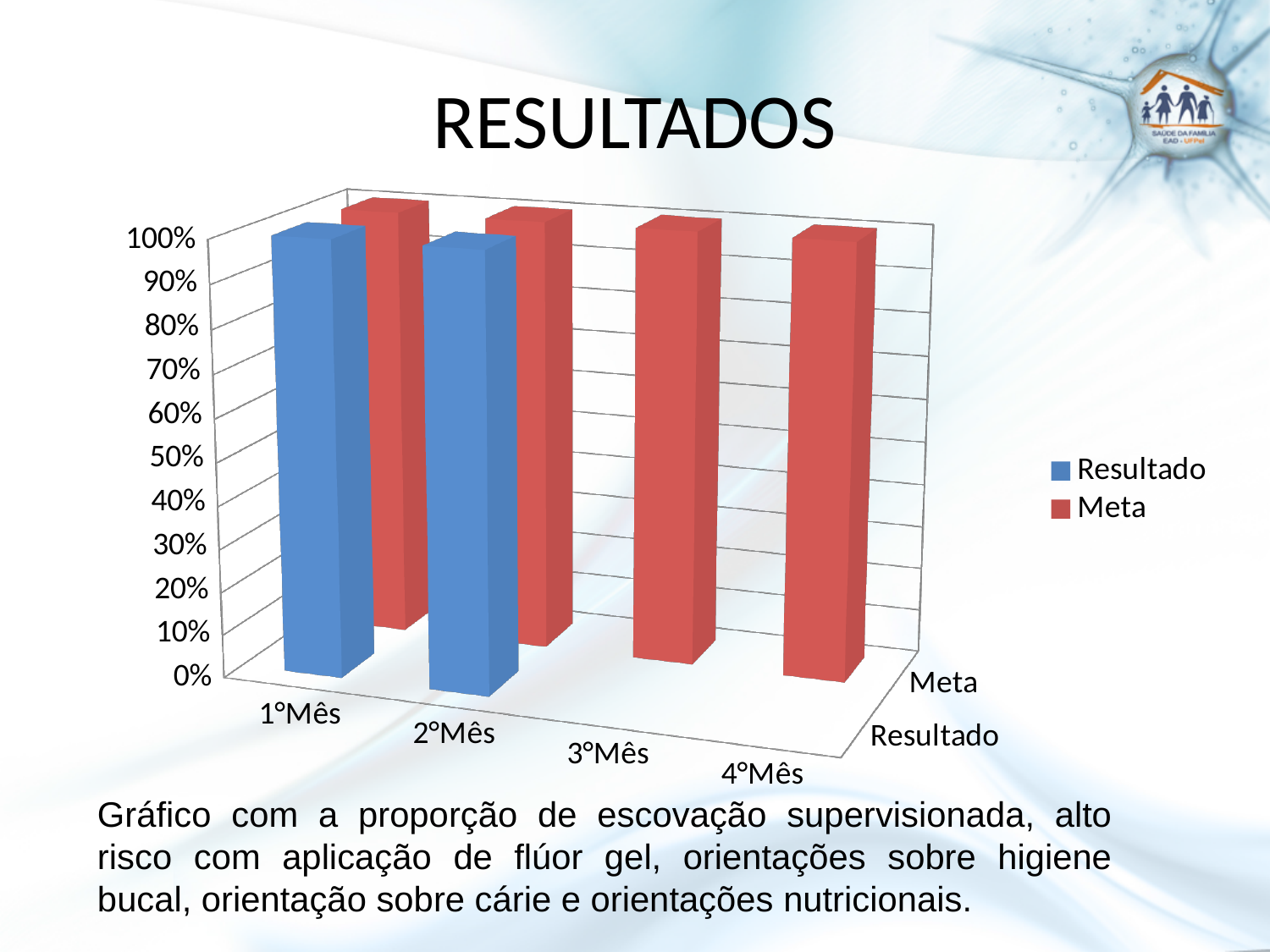
For how many months is a Resultado bar plotted? 2 Is the Resultado value for 1°Mês greater or less than 90%? greater What is the title of the slide containing the chart? RESULTADOS What are the two series named in the legend? Resultado and Meta Is the Meta value for 3°Mês greater or less than 50%? greater Is the Meta value for 4°Mês greater or less than 90%? greater Do the Meta values rise, fall, or stay the same from 1°Mês to 4°Mês? stay the same How many series does the chart legend list? 2 How many month categories are shown on the x axis? 4 What kind of chart is shown on the slide? Bar chart What is the highest percentage tick shown on the vertical axis? 100%